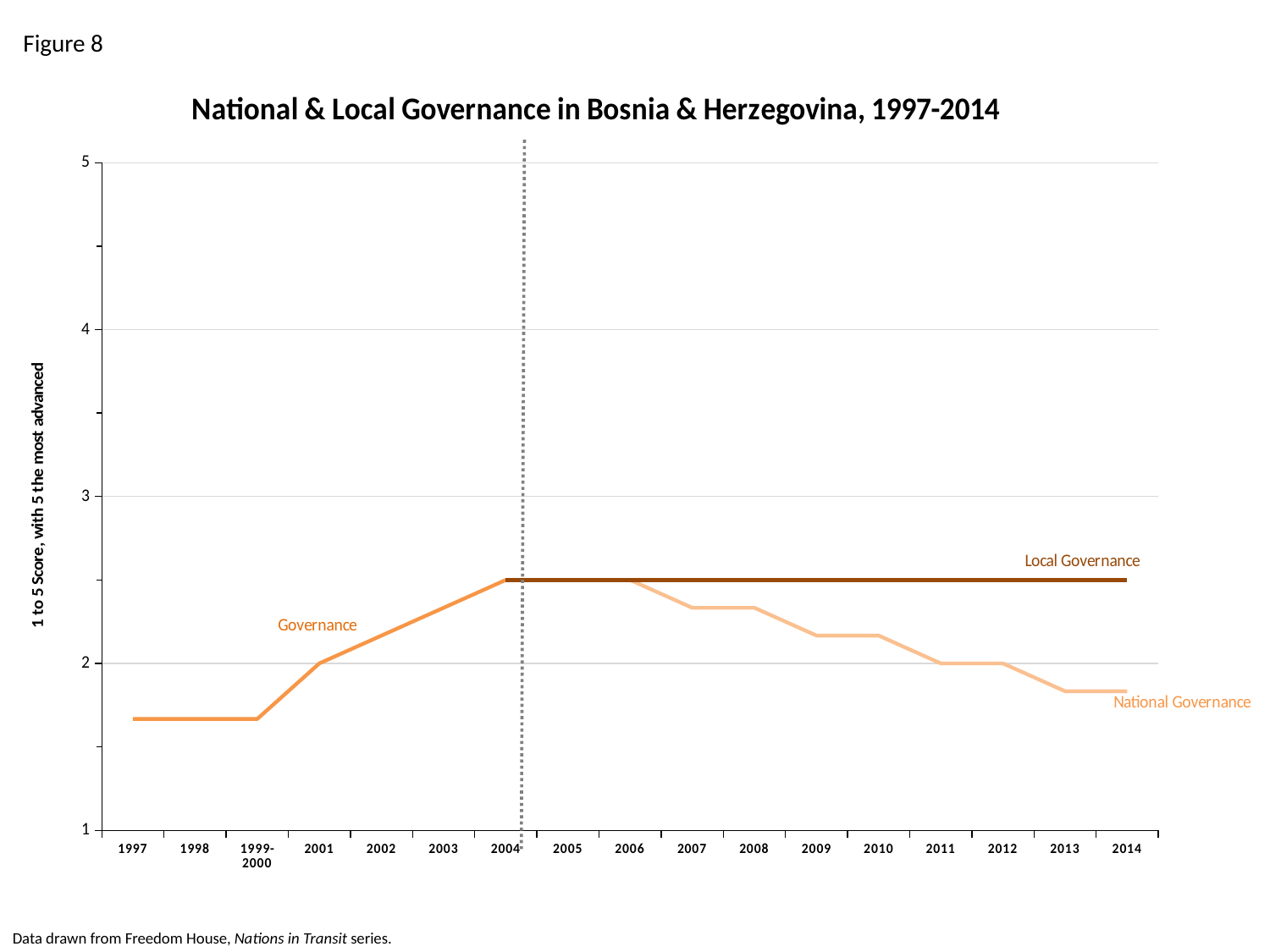
Does the Governance score rise or fall from 1999-2000 to 2004? rise How many categories are shown on the x axis? 17 What is the Governance score in 2001? 2 What is the National Governance score in 2011? 2 What kind of chart is shown on the slide? line chart Is the Local Governance score in 2010 greater or less than 2? greater Is the Governance score in 1997 greater or less than 2? less How many series are plotted on the chart? 3 In 2014, which is higher: Local Governance or National Governance? Local Governance Does the National Governance score rise or fall from 2006 to 2014? fall What is the title of the chart? National & Local Governance in Bosnia & Herzegovina, 1997-2014 Is the National Governance score in 2014 greater or less than 2? less